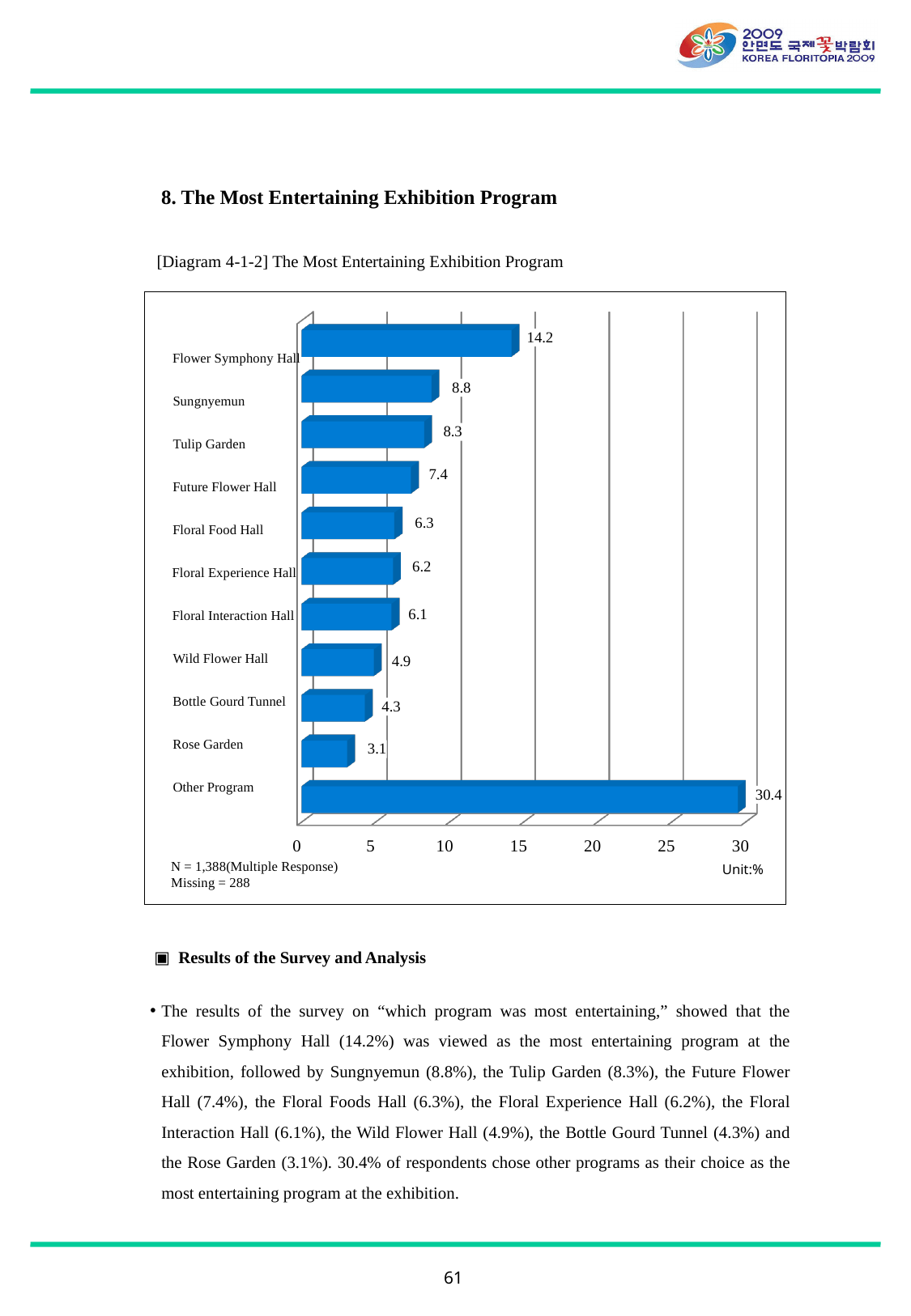
Which is larger, the value for Tulip Garden or the value for Future Flower Hall? Tulip Garden What unit is indicated for the values in the chart? % What is the value for Flower Symphony Hall? 14.2 What is the value for Bottle Gourd Tunnel? 4.3 What is the difference between the values for Other Program and Rose Garden? 27.3 What kind of chart is shown in Diagram 4-1-2? Bar chart What is the value for Sungnyemun? 8.8 Is the value for Other Program greater or less than 25? greater How many categories are shown in the chart? 11 Which category has the lowest value? Rose Garden What is the difference between the values for Flower Symphony Hall and Sungnyemun? 5.4 Which category has the highest value? Other Program